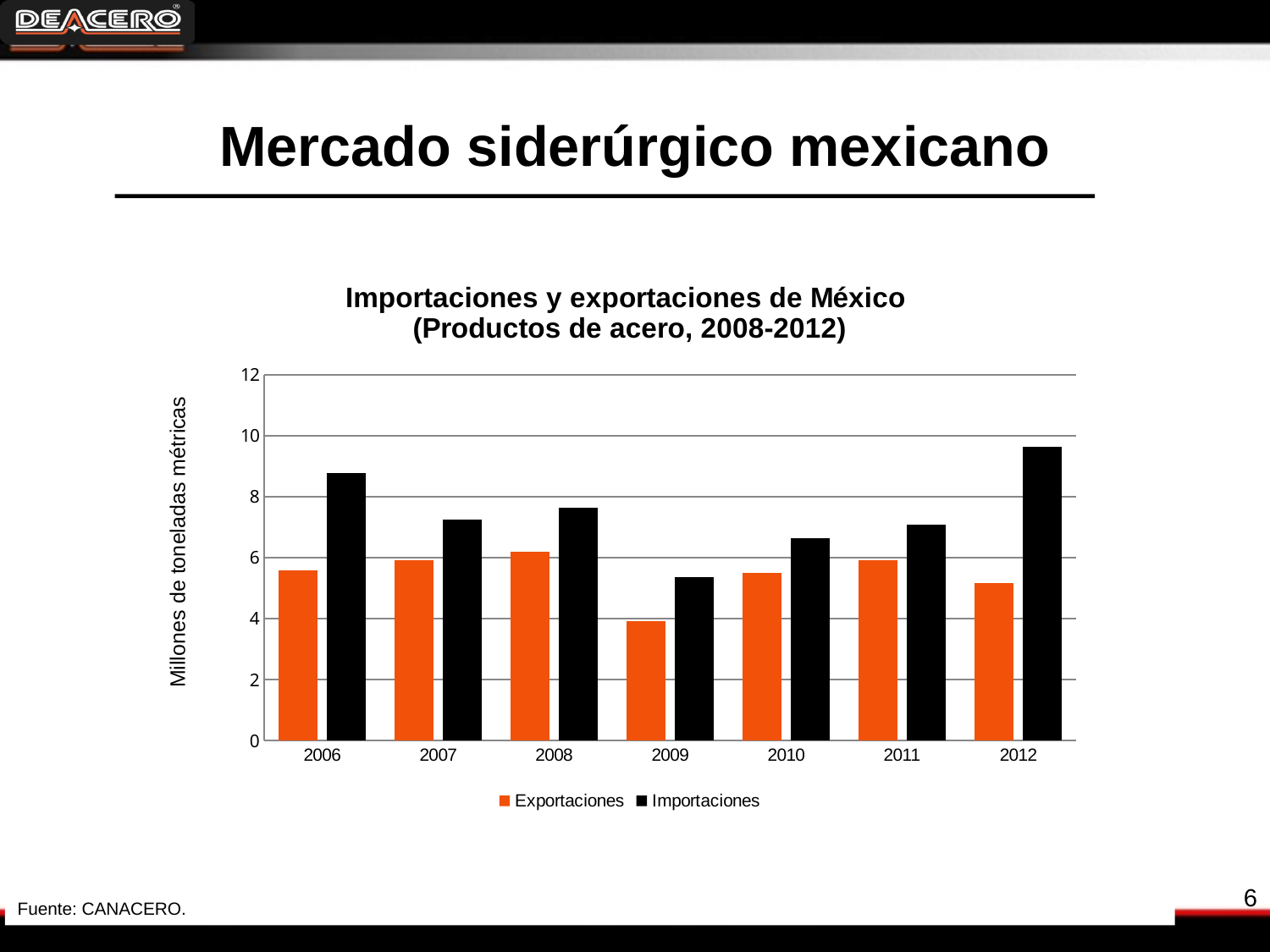
In which year are Importaciones highest? 2012 In which year are Exportaciones lowest? 2009 Do Importaciones rise or fall from 2009 to 2012? rise Is the value for Importaciones in 2012 greater or less than 8? greater Is the value for Importaciones in 2009 greater or less than 6? less What is the label on the vertical axis? Millones de toneladas métricas Is the value for Exportaciones in 2006 greater or less than 6? less How many series does the legend list? 2 What kind of chart is shown on the slide? bar chart In 2012, which is larger: Exportaciones or Importaciones? Importaciones How many years are shown on the x axis? 7 In which year are Importaciones lowest? 2009